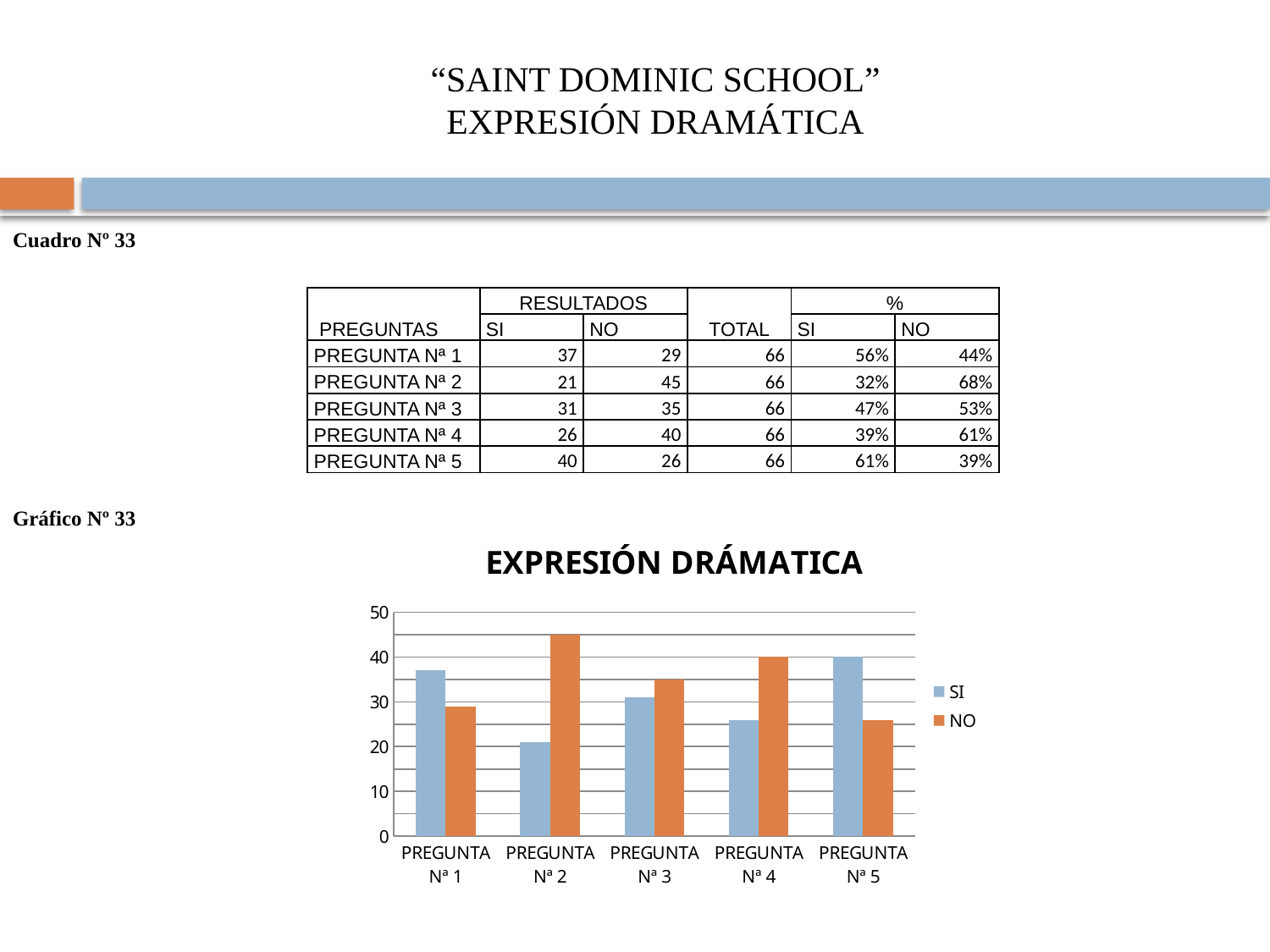
For PREGUNTA Nª 1, which is larger, SI or NO? SI What type of chart is shown under Gráfico Nº 33? bar chart What is the difference between the SI and NO values for PREGUNTA Nª 2? 24 Is the SI value for PREGUNTA Nª 2 greater or less than 30? less How many series does the legend of the EXPRESIÓN DRÁMATICA chart list? 2 Which pregunta has the highest NO value in the chart? PREGUNTA Nª 2 What is the NO value for PREGUNTA Nª 4 in the chart? 40 What is the SI value for PREGUNTA Nª 5 in the chart? 40 What colour are the NO bars in the chart? orange Which pregunta has the lowest SI value in the chart? PREGUNTA Nª 2 Is the NO value for PREGUNTA Nª 2 greater or less than 40? greater How many categories (preguntas) are shown on the x axis of the chart? 5